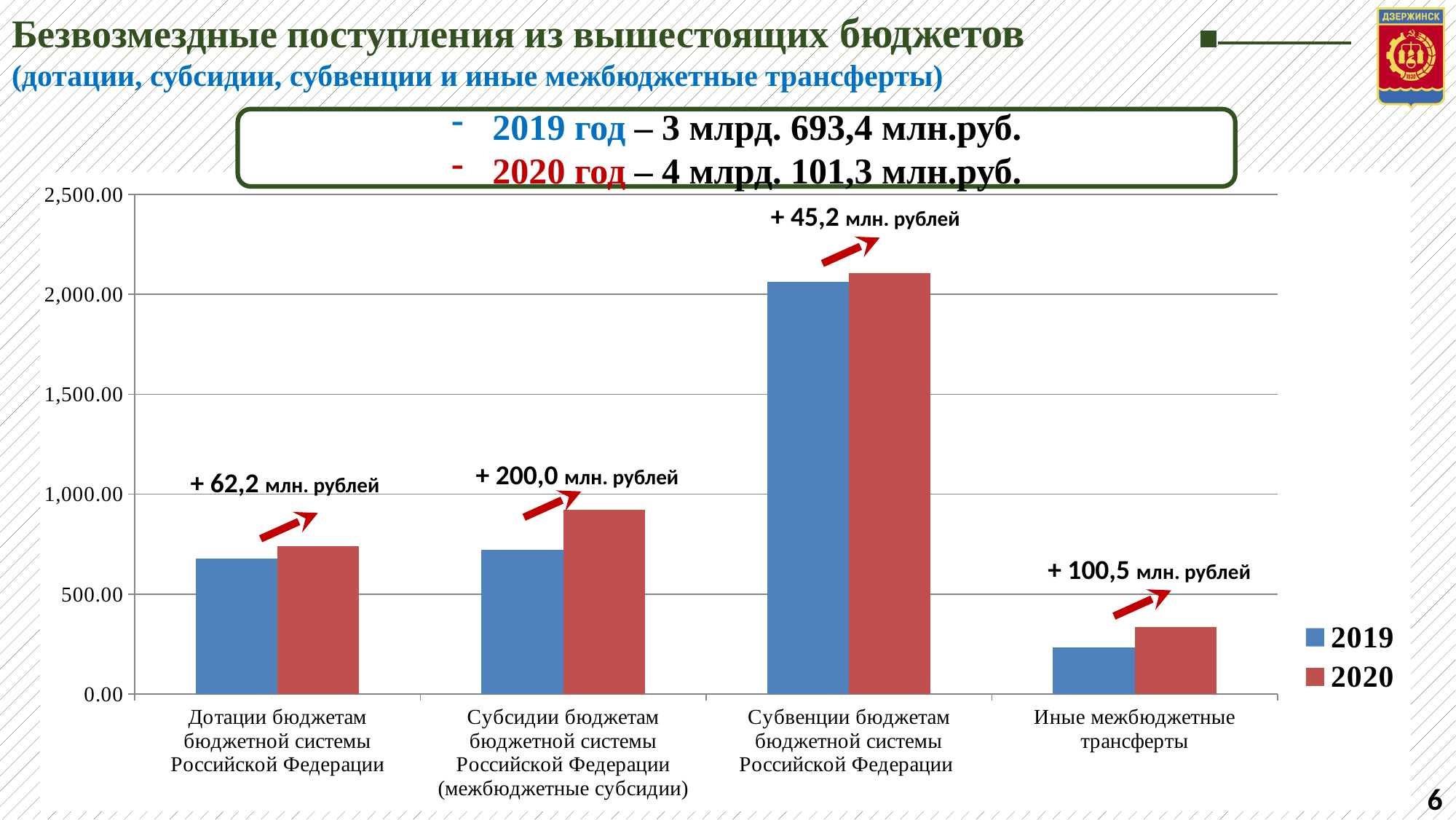
What increase from 2019 to 2020 is annotated for Иные межбюджетные трансферты? + 100,5 млн. рублей Which category has the lowest bars in the chart? Иные межбюджетные трансферты Which category has the highest bars in the chart? Субвенции бюджетам бюджетной системы Российской Федерации How many series does the chart legend list? 2 For Субсидии бюджетам бюджетной системы Российской Федерации (межбюджетные субсидии), which is larger: the 2019 value or the 2020 value? 2020 What kind of chart is shown on the slide? bar chart Which colour represents the 2020 series in the chart legend? red Is the 2020 value for Субвенции бюджетам бюджетной системы Российской Федерации greater or less than 2,000.00? greater Is the 2019 value for Иные межбюджетные трансферты greater or less than 500.00? less What increase from 2019 to 2020 is annotated for Дотации бюджетам бюджетной системы Российской Федерации? + 62,2 млн. рублей What increase from 2019 to 2020 is annotated for Субсидии бюджетам бюджетной системы Российской Федерации (межбюджетные субсидии)? + 200,0 млн. рублей How many categories are shown on the x axis of the chart? 4